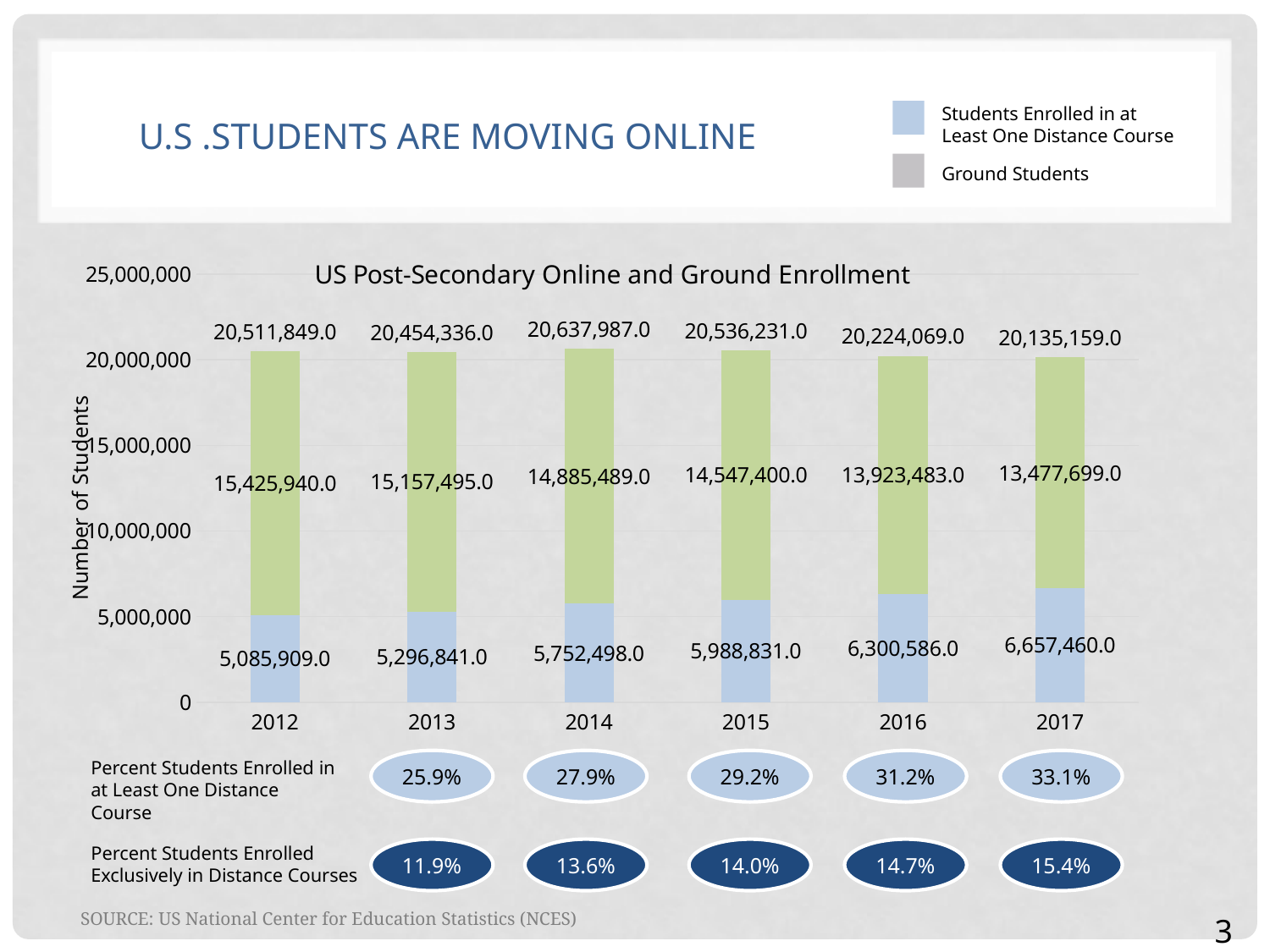
What is the difference between the number of students enrolled in at least one distance course in 2017 and in 2012? 1,571,551.0 What is the total enrollment shown above the bar for 2014? 20,637,987.0 Which year has the lowest number of students enrolled in at least one distance course? 2012 How many series does the legend list? 2 Do the numbers of students enrolled in at least one distance course rise or fall from 2012 to 2017? rise What is the title of the chart? US Post-Secondary Online and Ground Enrollment Which is larger: the number of ground students in 2013 or in 2016? 2013 What kind of chart is used to show US Post-Secondary Online and Ground Enrollment? stacked bar chart Which year has the highest total enrollment? 2014 What is the number of ground students in 2017? 13,477,699.0 What is the number of students enrolled in at least one distance course in 2012? 5,085,909.0 How many years are shown on the x axis of the chart? 6